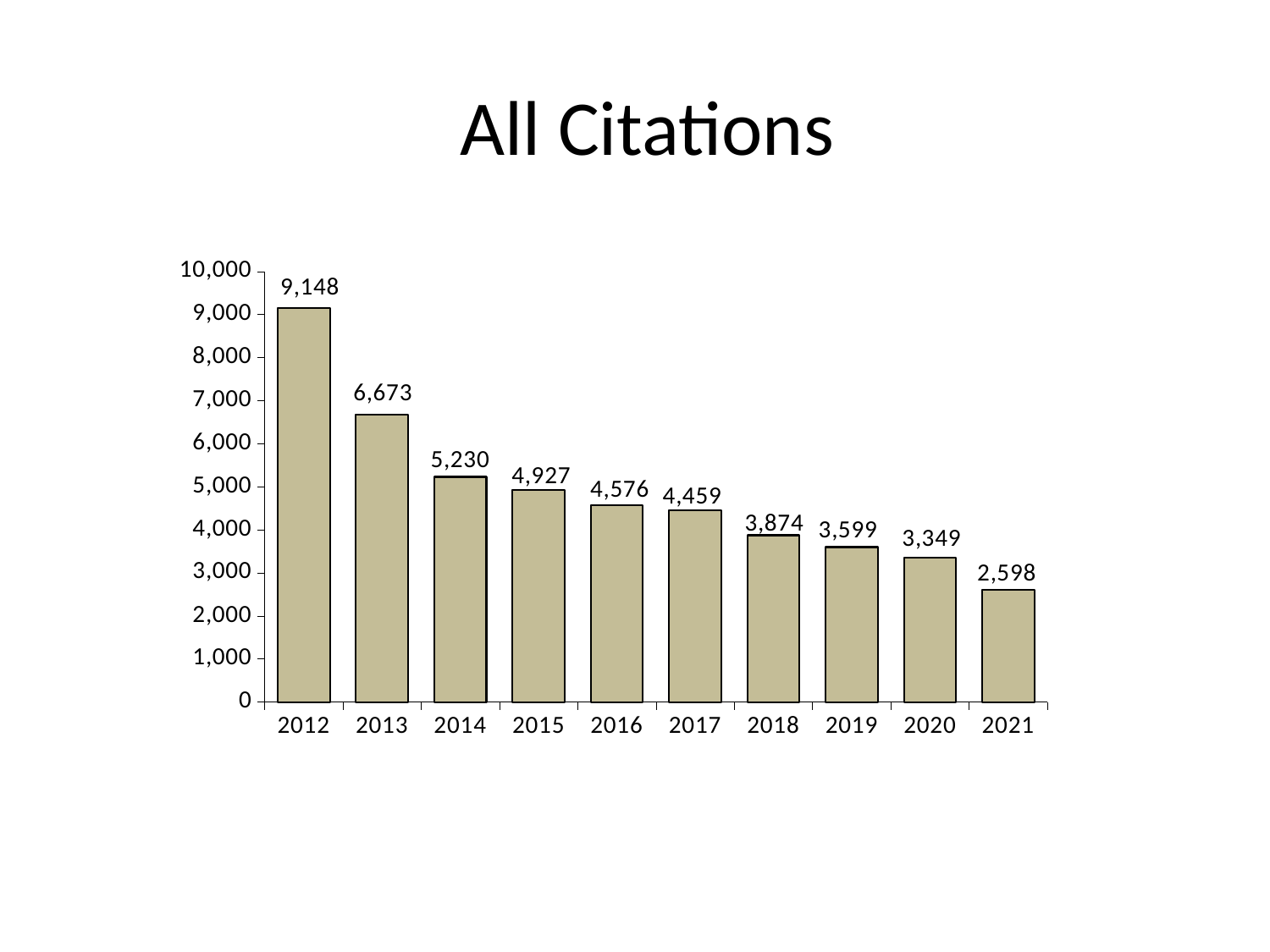
Do the values rise or fall from 2012 to 2021? fall What is the value for 2017? 4,459 What is the difference between the values for 2012 and 2013? 2,475 What is the difference between the values for 2020 and 2021? 751 How many years are shown on the x axis? 10 Is the value for 2018 greater or less than 4,000? less Which year has the highest value? 2012 What kind of chart is shown on the slide? bar chart What is the value for 2021? 2,598 What is the value for 2012? 9,148 Which year has the lowest value? 2021 Which is larger, the value for 2014 or the value for 2016? 2014